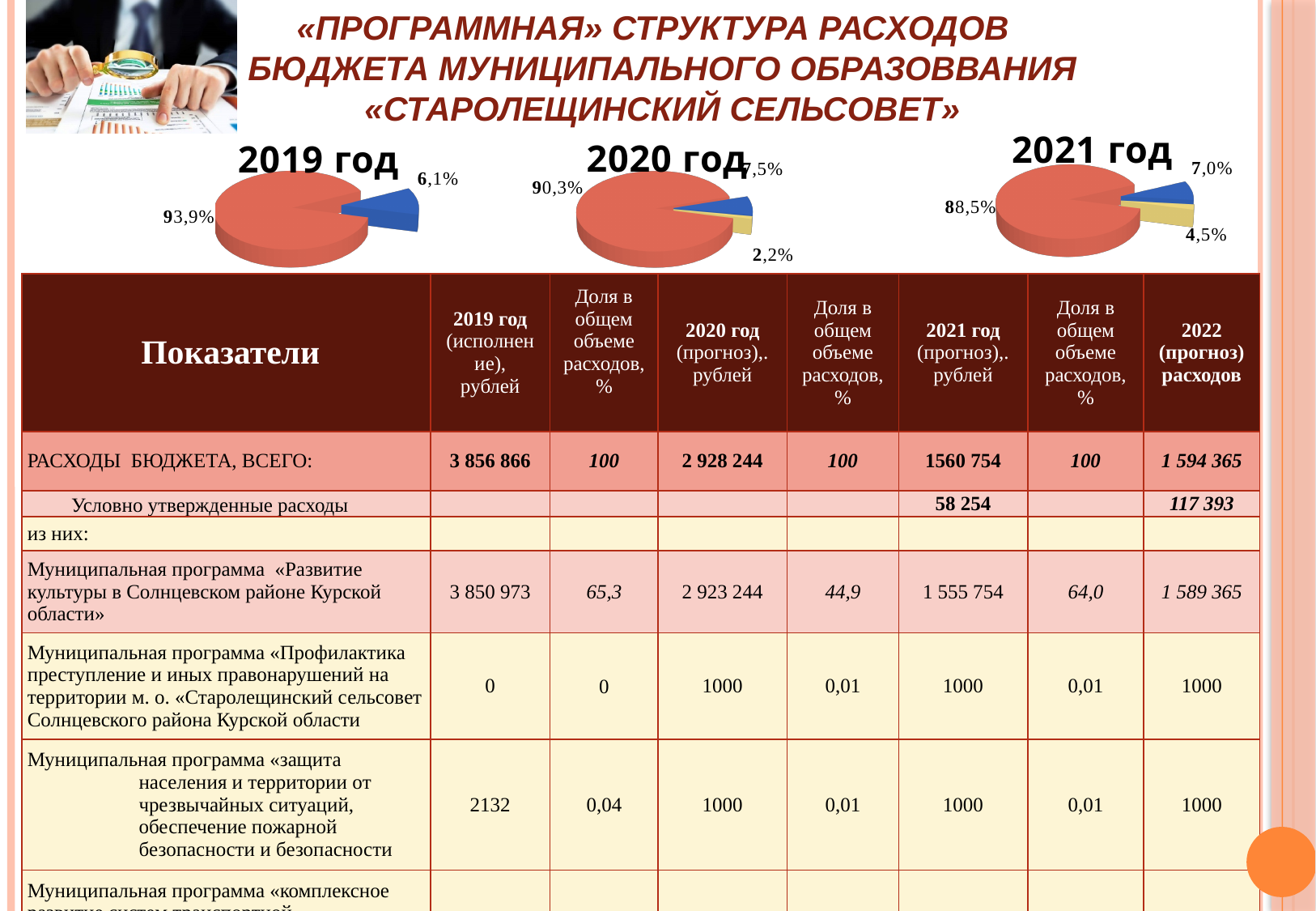
In the 2021 год pie chart, what is the share of the largest slice? 88,5% How many slices does the 2020 год pie chart have? 3 What kind of chart is used for the 2019 год chart? pie chart In the 2019 год pie chart, what is the share of the smallest slice? 6,1% In the 2020 год pie chart, what is the share of the smallest slice? 2,2% In the 2019 год pie chart, what is the difference between the two slices' shares? 87,8% In the 2019 год pie chart, what is the share of the largest slice? 93,9% How many slices does the 2019 год pie chart have? 2 In the 2021 год pie chart, what is the share of the blue slice? 7,0% In the 2020 год pie chart, what is the share of the largest slice? 90,3% In the 2021 год pie chart, what is the share of the smallest slice? 4,5% Which is larger: the largest slice of the 2019 год pie chart or the largest slice of the 2021 год pie chart? 2019 год (93,9%)